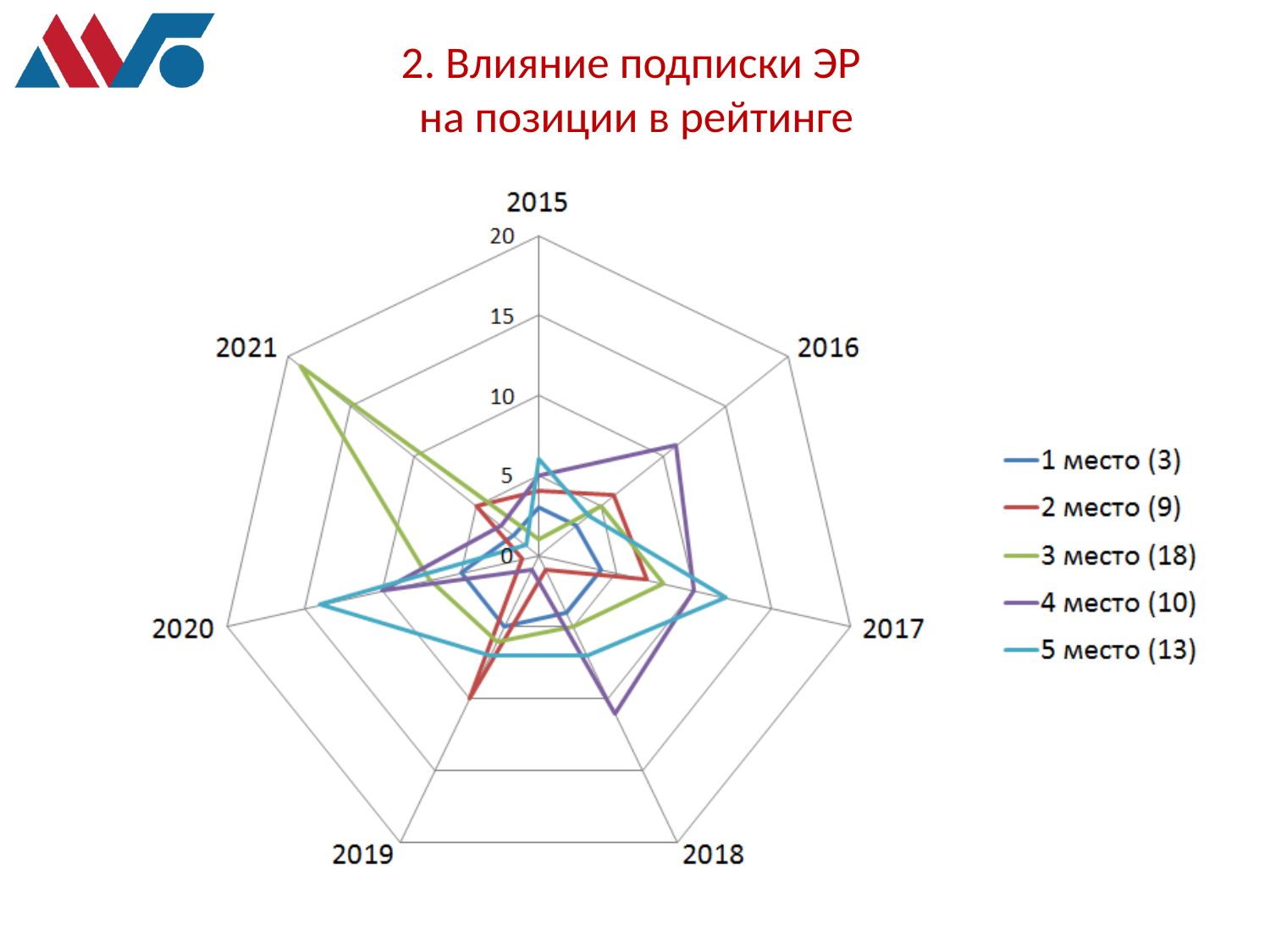
How many year categories (axes) does the radar chart have? 7 Is the value for "3 место (18)" in 2021 greater or less than 15? greater What kind of chart is shown on the slide? radar chart Is the value for "1 место (3)" in 2015 greater or less than 5? less In which year does the series "3 место (18)" reach its highest value? 2021 What is the title of the slide containing the chart? 2. Влияние подписки ЭР на позиции в рейтинге Which series has the highest value for 2018? 4 место (10) Which colour represents the series "3 место (18)" in the legend? green Which series has the highest value for 2020? 5 место (13) How many series does the legend list? 5 For 2015, which is larger: the value for "5 место (13)" or the value for "1 место (3)"? 5 место (13)